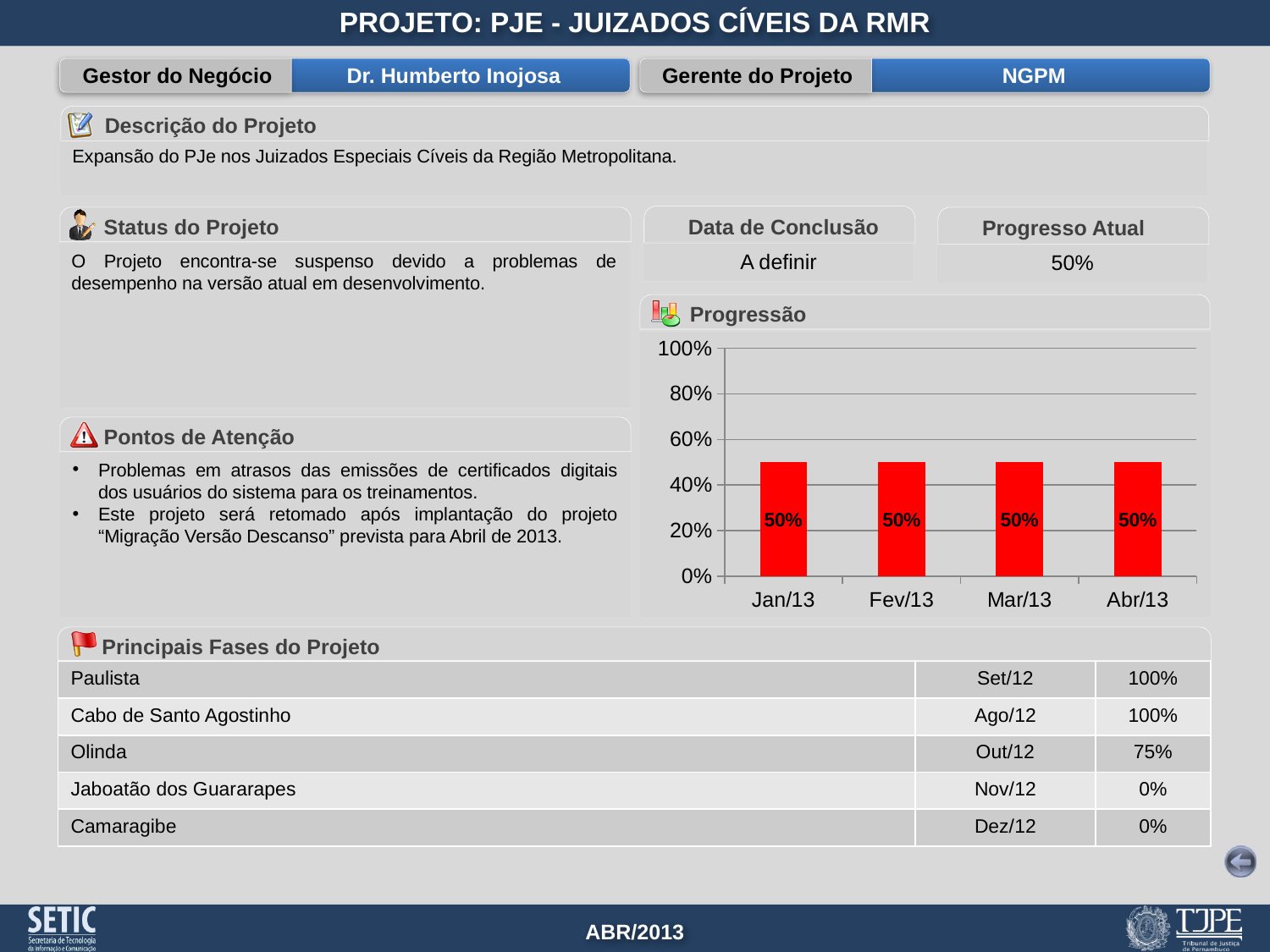
What is the title of the chart on the slide? Progressão How many months are shown on the x axis of the Progressão chart? 4 What is the value for Jan/13 in the Progressão chart? 50% What is the difference between the values for Jan/13 and Abr/13 in the Progressão chart? 0% Is the value for Fev/13 in the Progressão chart greater or less than 60%? less What is the value for Abr/13 in the Progressão chart? 50% What is the value for Mar/13 in the Progressão chart? 50% Is the value for Mar/13 in the Progressão chart greater or less than 40%? greater What is the value for Fev/13 in the Progressão chart? 50% What colour are the bars in the Progressão chart? red Do the values in the Progressão chart rise, fall or stay the same from Jan/13 to Abr/13? stay the same What kind of chart is the Progressão chart? bar chart